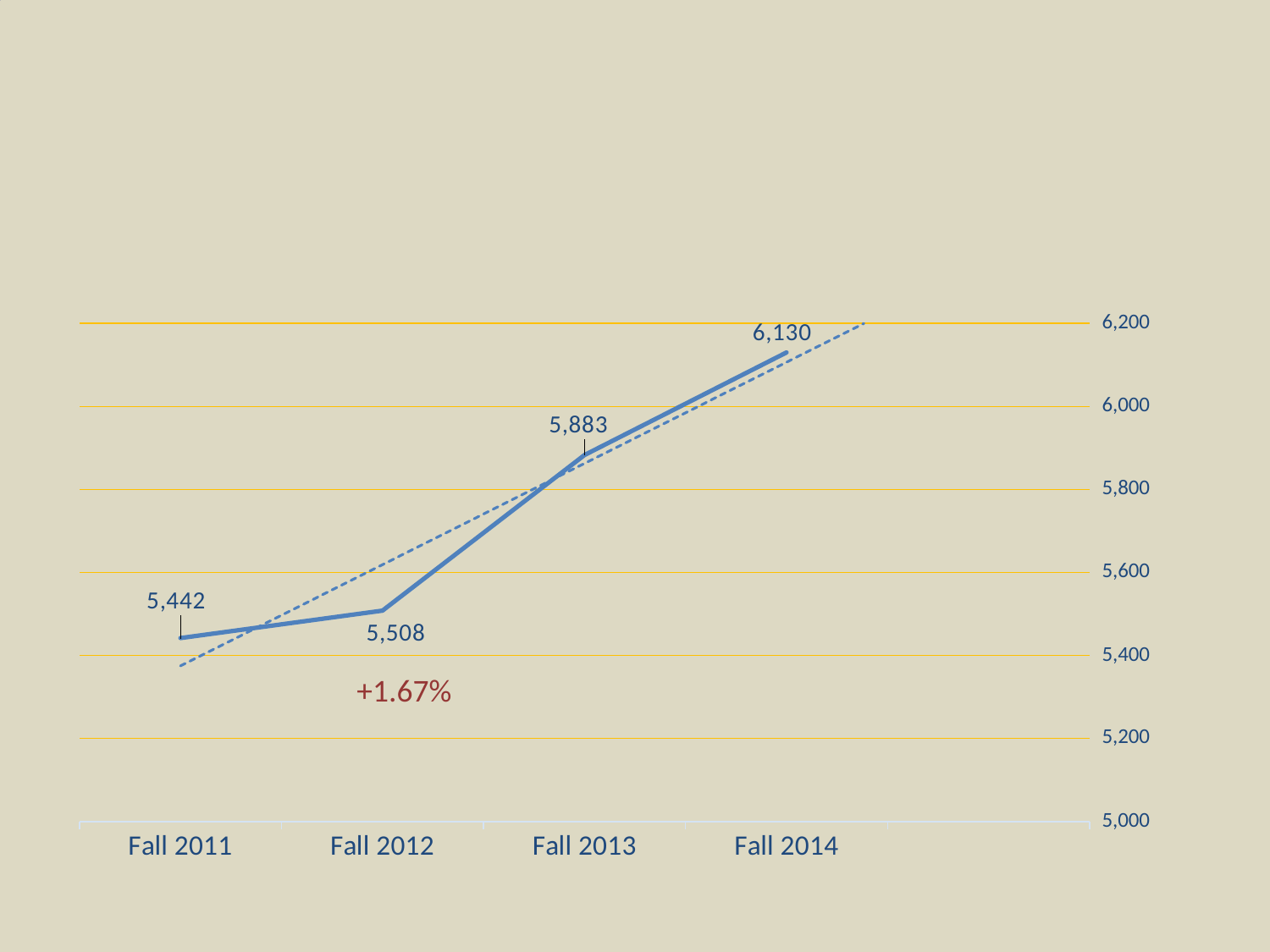
What is the value for Fall 2011? 5,442 How many data points are plotted on the line? 4 What kind of chart is shown on the slide? Line chart Which category has the highest value? Fall 2014 What is the value for Fall 2012? 5,508 What is the value for Fall 2013? 5,883 Do the values rise or fall from Fall 2011 to Fall 2014? Rise Which is larger, the value for Fall 2013 or the value for Fall 2012? Fall 2013 What is the difference between the Fall 2012 and Fall 2011 values? 66 What is the value for Fall 2014? 6,130 What is the difference between the Fall 2014 and Fall 2013 values? 247 Which category has the lowest value? Fall 2011